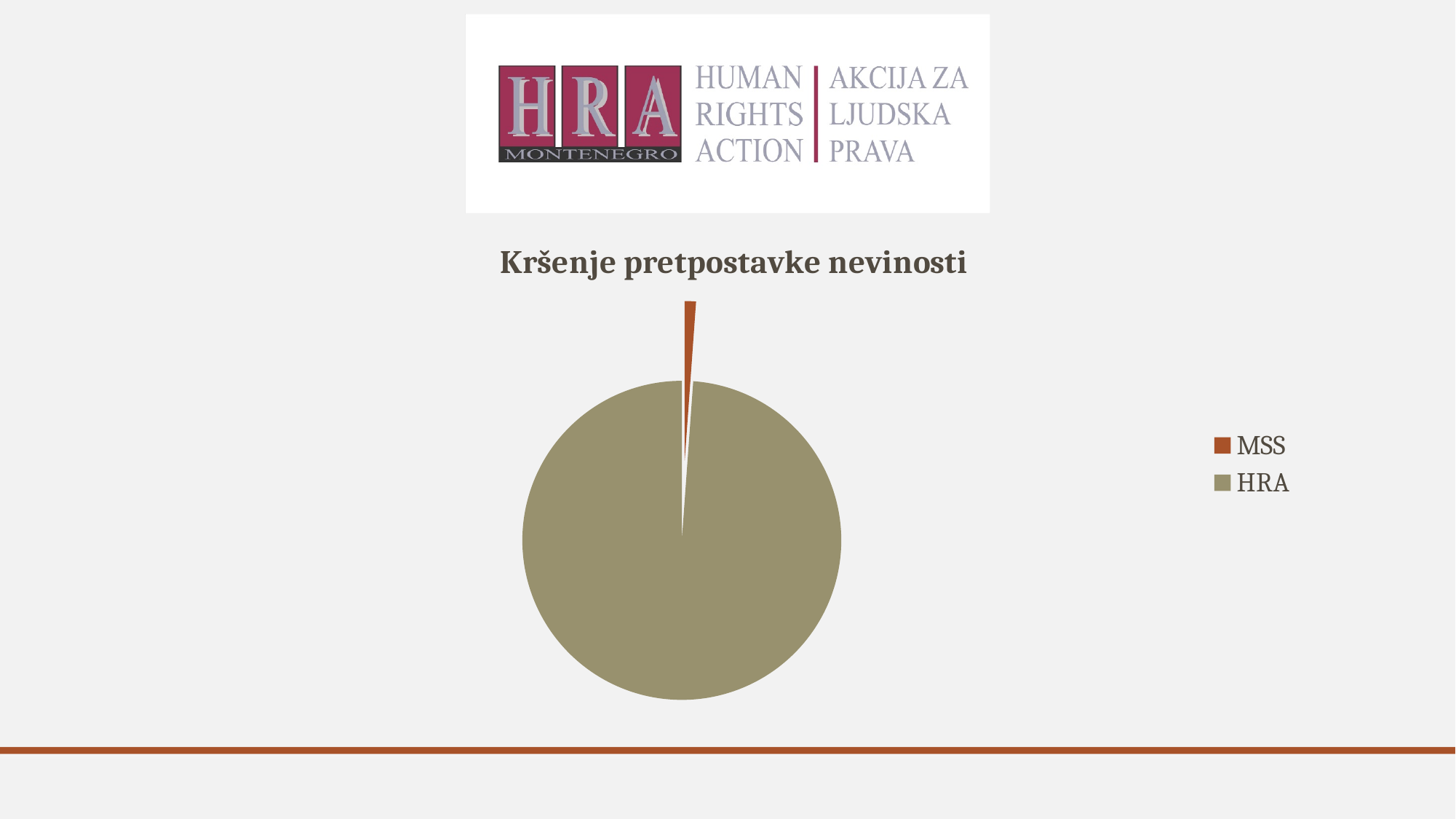
What is the title of the chart? Kršenje pretpostavke nevinosti Which legend entry is shown in the orange-brown colour? MSS Which slice is larger, MSS or HRA? HRA What kind of chart is shown on the slide? pie chart How many entries does the legend list? 2 How many slices does the pie chart have? 2 Which category has the smallest slice of the pie? MSS Which category has the largest slice of the pie? HRA